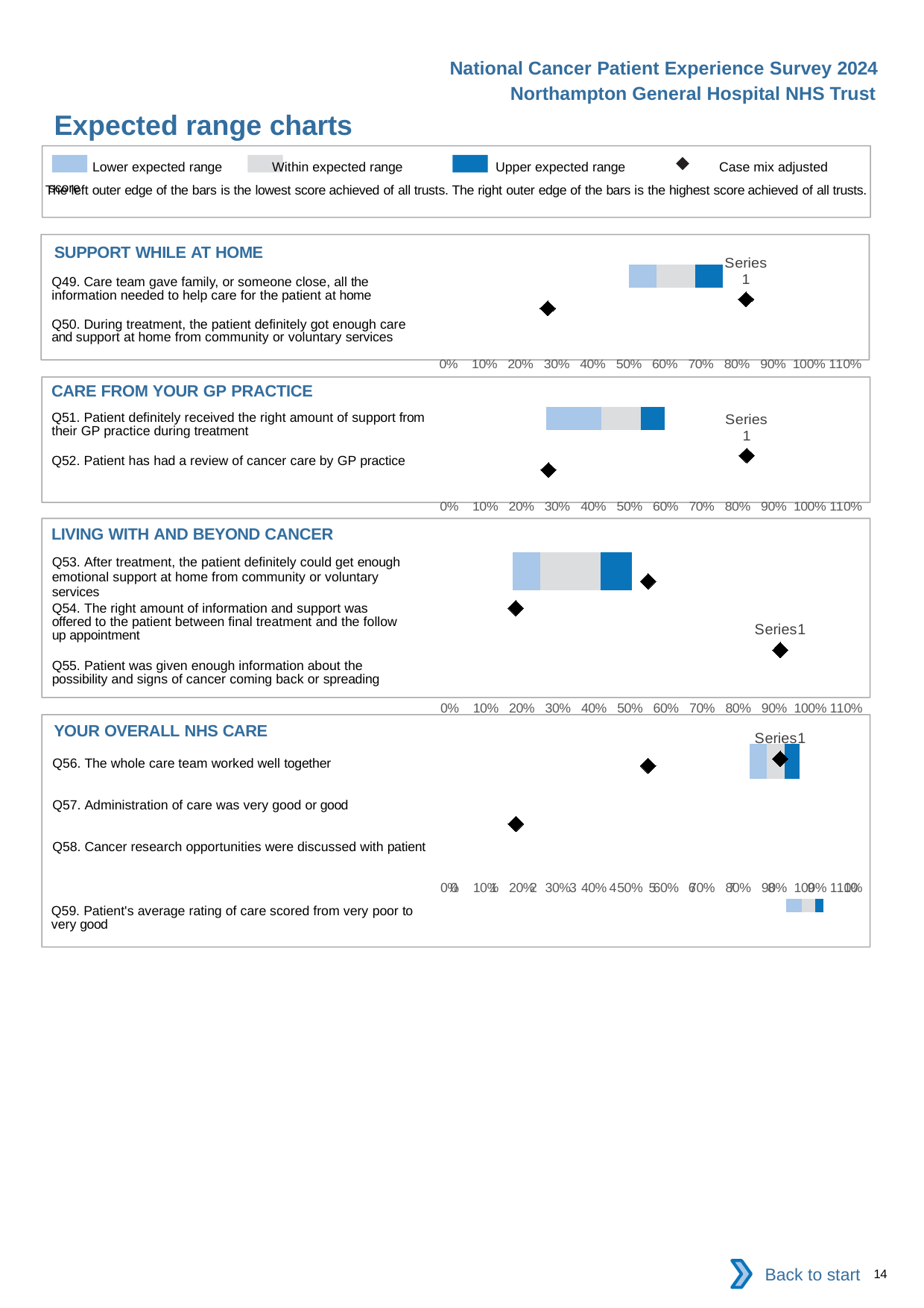
How many section charts are shown on the slide? 4 How many questions are listed in the 'YOUR OVERALL NHS CARE' chart? 4 How many entries does the legend at the top of the slide list? 4 In the 'CARE FROM YOUR GP PRACTICE' chart, is the left outer edge of the bar greater or less than 20%? greater How many questions are listed in the 'LIVING WITH AND BEYOND CANCER' chart? 3 What is the highest percentage tick shown on the x axis of the 'SUPPORT WHILE AT HOME' chart? 110% In the 'SUPPORT WHILE AT HOME' chart, is the left outer edge of the bar greater or less than 40%? greater In the 'SUPPORT WHILE AT HOME' chart, is the right outer edge of the bar greater or less than 90%? less What does the black diamond marker represent according to the legend? Case mix adjusted score What kind of chart is used in the 'SUPPORT WHILE AT HOME' section? Bar chart